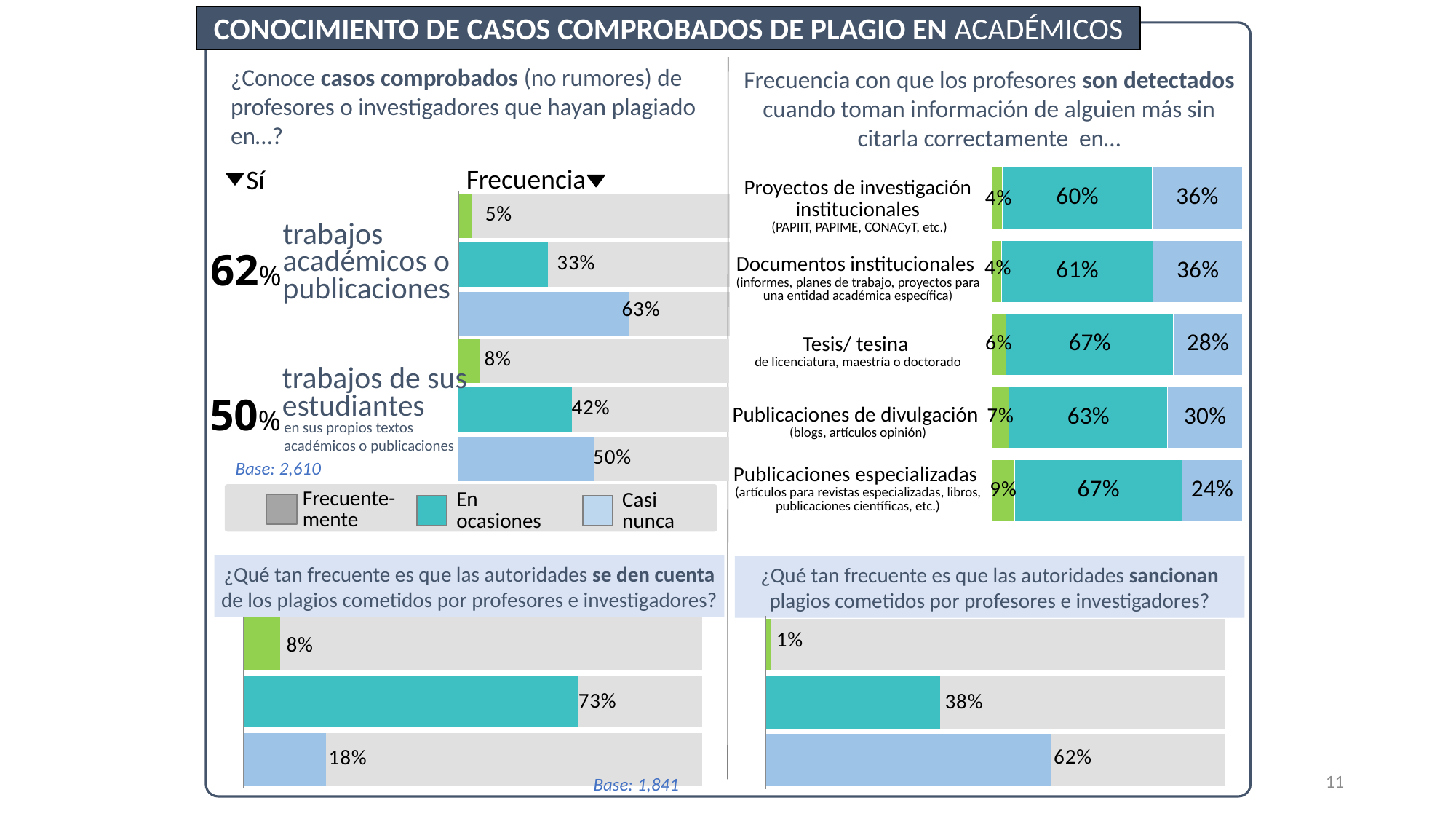
In the top-right chart on the frequency with which professors are detected, which category has the highest 'Frecuentemente' value? Publicaciones especializadas What kind of chart is the bottom-right chart on how often authorities sanction plagiarism? Bar chart In the top-left 'Frecuencia' chart, how many series does the legend list? 3 In the top-right chart on the frequency with which professors are detected, what is the 'En ocasiones' value for Tesis/ tesina? 67% In the top-right chart on the frequency with which professors are detected, what is the difference between the 'Casi nunca' values for Documentos institucionales and Tesis/ tesina? 8% In the top-right chart on the frequency with which professors are detected, which category has the lowest 'Casi nunca' value? Publicaciones especializadas In the top-left 'Frecuencia' chart, what is the 'En ocasiones' value for trabajos de sus estudiantes? 42% In the top-left 'Frecuencia' chart, what is the 'Casi nunca' value for trabajos académicos o publicaciones? 63% In the top-right chart on the frequency with which professors are detected, how many categories are shown? 5 In the top-right chart on the frequency with which professors are detected, what is the 'Casi nunca' value for Publicaciones especializadas? 24% In the bottom-right chart on how often authorities sanction plagiarism, which is larger: the 'En ocasiones' value or the 'Casi nunca' value? Casi nunca In the bottom-left chart on how often authorities notice plagiarism, what is the 'En ocasiones' value? 73%